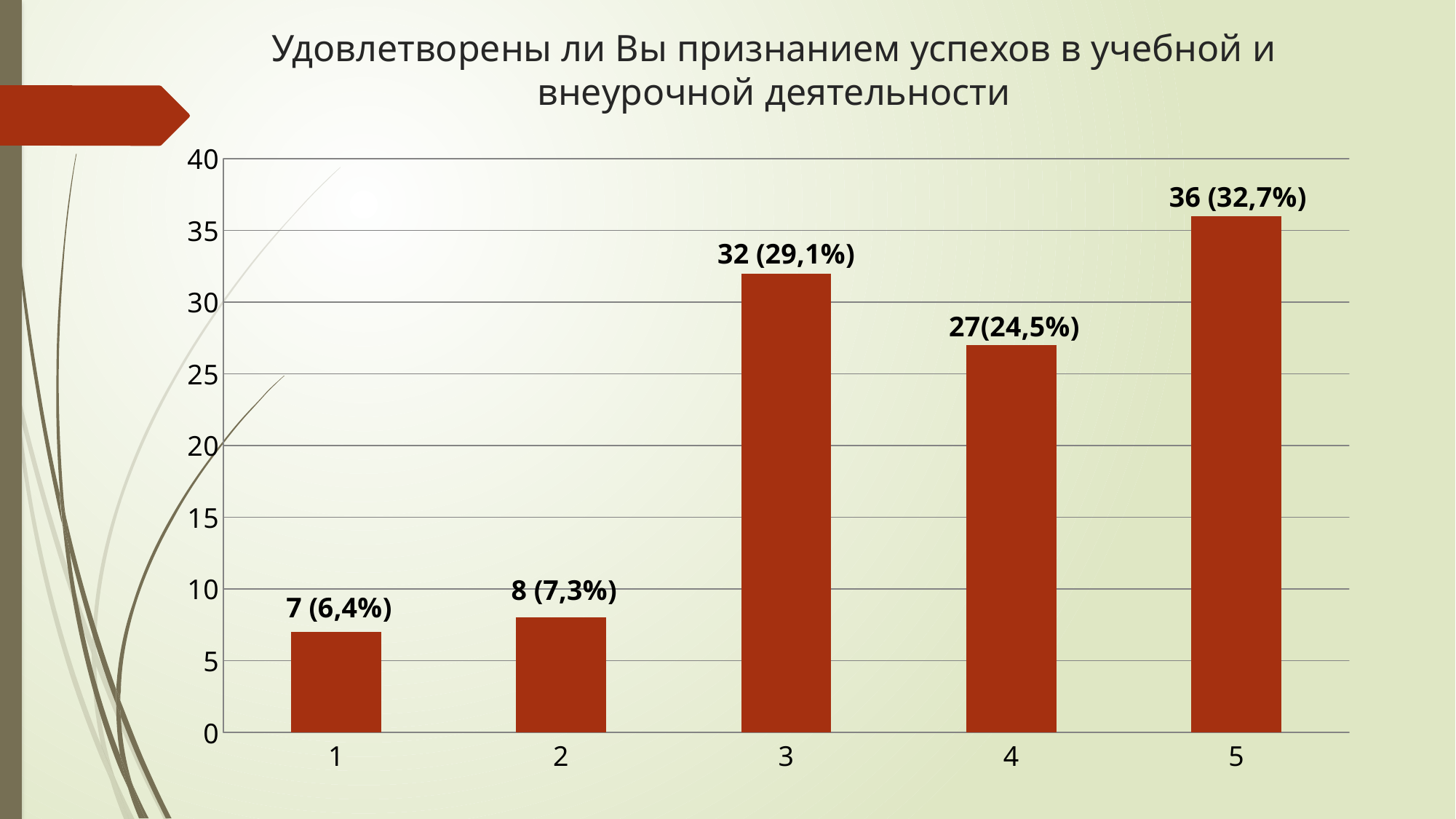
What percentage is shown in the data label for category 4? 24,5% Is the value for category 4 greater or less than 25? greater Which category has the highest value? 5 What is the difference between the count for category 2 and the count for category 1? 1 What is the data label shown for category 3? 32 (29,1%) What is the maximum value shown on the vertical axis? 40 Which is larger, the value for category 3 or the value for category 4? 3 What is the difference between the count for category 5 and the count for category 3? 4 Which category has the lowest value? 1 What is the data label shown for category 1? 7 (6,4%) How many categories are shown on the x axis? 5 What kind of chart is shown on the slide? bar chart